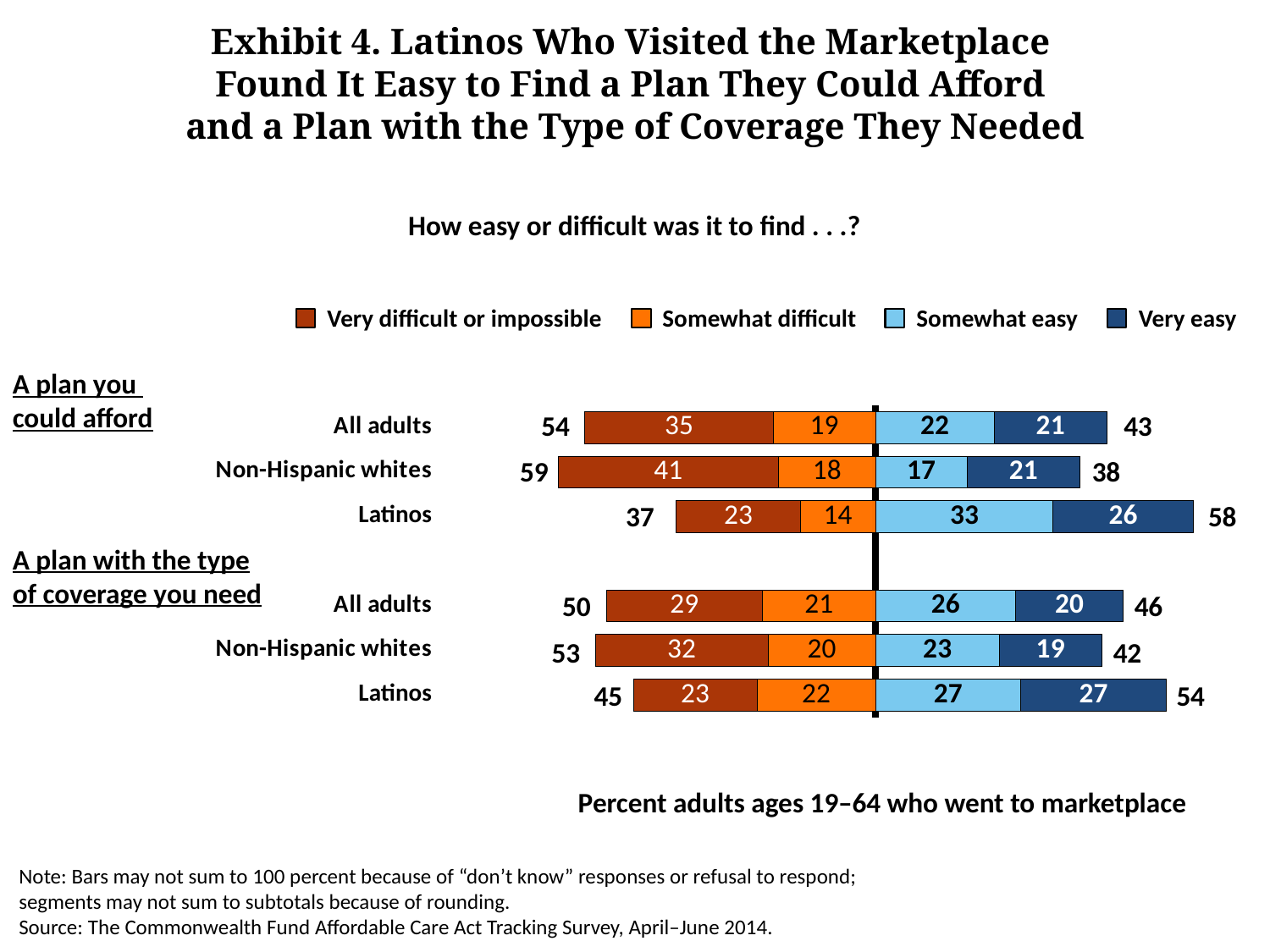
What percentage of Non-Hispanic whites said it was "Very difficult or impossible" to find a plan they could afford? 41 How many response categories does the legend list? 4 How many bars (group rows) are plotted in the chart? 6 What is the combined "easy" subtotal shown for Latinos for finding a plan they could afford? 58 What kind of chart is shown on the slide? Stacked bar chart Which group has the lowest "Somewhat difficult" value for finding a plan they could afford? Latinos What percentage of Latinos said it was "Somewhat easy" to find a plan they could afford? 33 For finding a plan with the type of coverage you need, which is larger: the "Very easy" value for Latinos or for Non-Hispanic whites? Latinos What is the difference between the "Somewhat easy" values for Latinos and Non-Hispanic whites for finding a plan they could afford? 16 Which legend category is shown in the darkest blue colour? Very easy Which group has the highest "Very difficult or impossible" value for finding a plan they could afford? Non-Hispanic whites What percentage of all adults said it was "Very easy" to find a plan with the type of coverage they need? 20